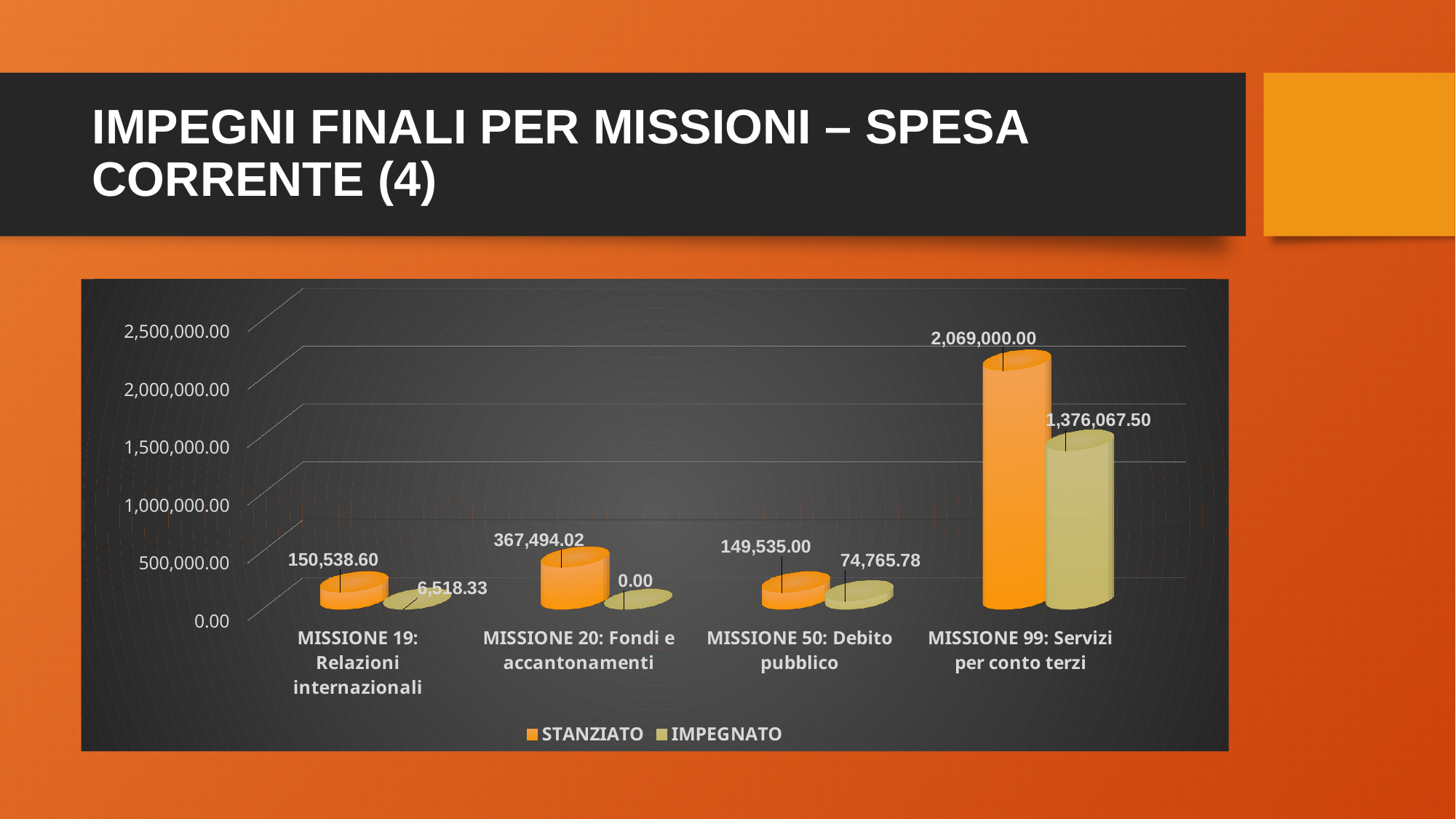
What is the difference between the STANZIATO and IMPEGNATO values for MISSIONE 50: Debito pubblico? 74,769.22 How many missions (categories) are shown on the x axis? 4 How many series does the legend list? 2 What kind of chart is shown on the slide? Bar chart What is the STANZIATO value for MISSIONE 50: Debito pubblico? 149,535.00 What is the IMPEGNATO value for MISSIONE 20: Fondi e accantonamenti? 0.00 Which mission has the highest IMPEGNATO value? MISSIONE 99: Servizi per conto terzi Which is larger: the STANZIATO value for MISSIONE 20: Fondi e accantonamenti or the STANZIATO value for MISSIONE 19: Relazioni internazionali? MISSIONE 20: Fondi e accantonamenti What is the difference between the STANZIATO and IMPEGNATO values for MISSIONE 99: Servizi per conto terzi? 692,932.50 What is the IMPEGNATO value for MISSIONE 19: Relazioni internazionali? 6,518.33 Which mission has the lowest STANZIATO value? MISSIONE 50: Debito pubblico What is the STANZIATO value for MISSIONE 99: Servizi per conto terzi? 2,069,000.00